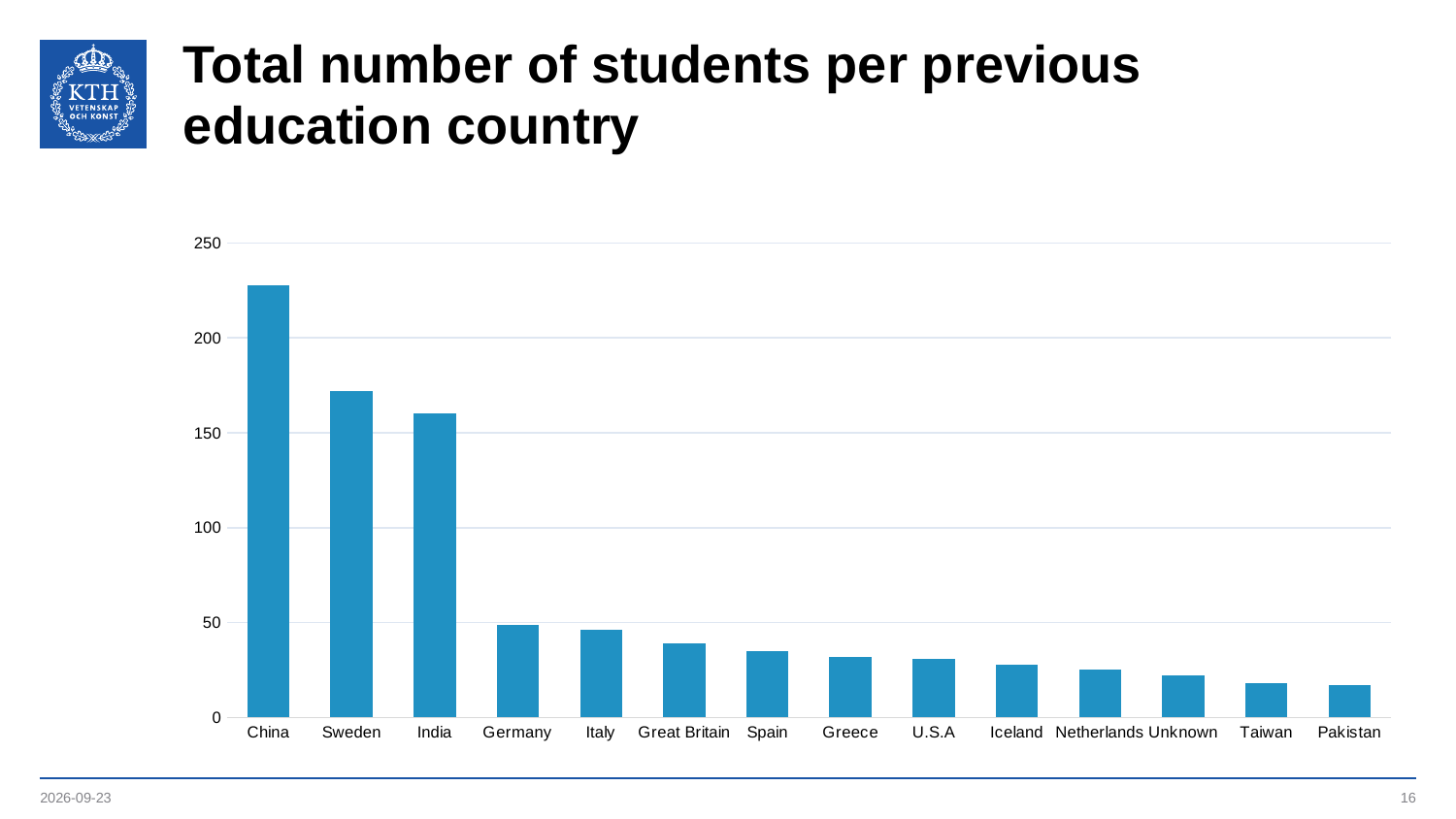
Which has more students, Sweden or India? Sweden What is the title of the chart? Total number of students per previous education country Is the value for Pakistan greater or less than 50? less Is the value for India greater or less than 150? greater What kind of chart is shown on the slide? Bar chart Do the values rise or fall moving from left to right along the x axis? Fall Which has more students, Germany or Taiwan? Germany How many countries (categories) are shown on the x axis of the chart? 14 Is the value for China greater or less than 200? greater Which country has the highest number of students? China